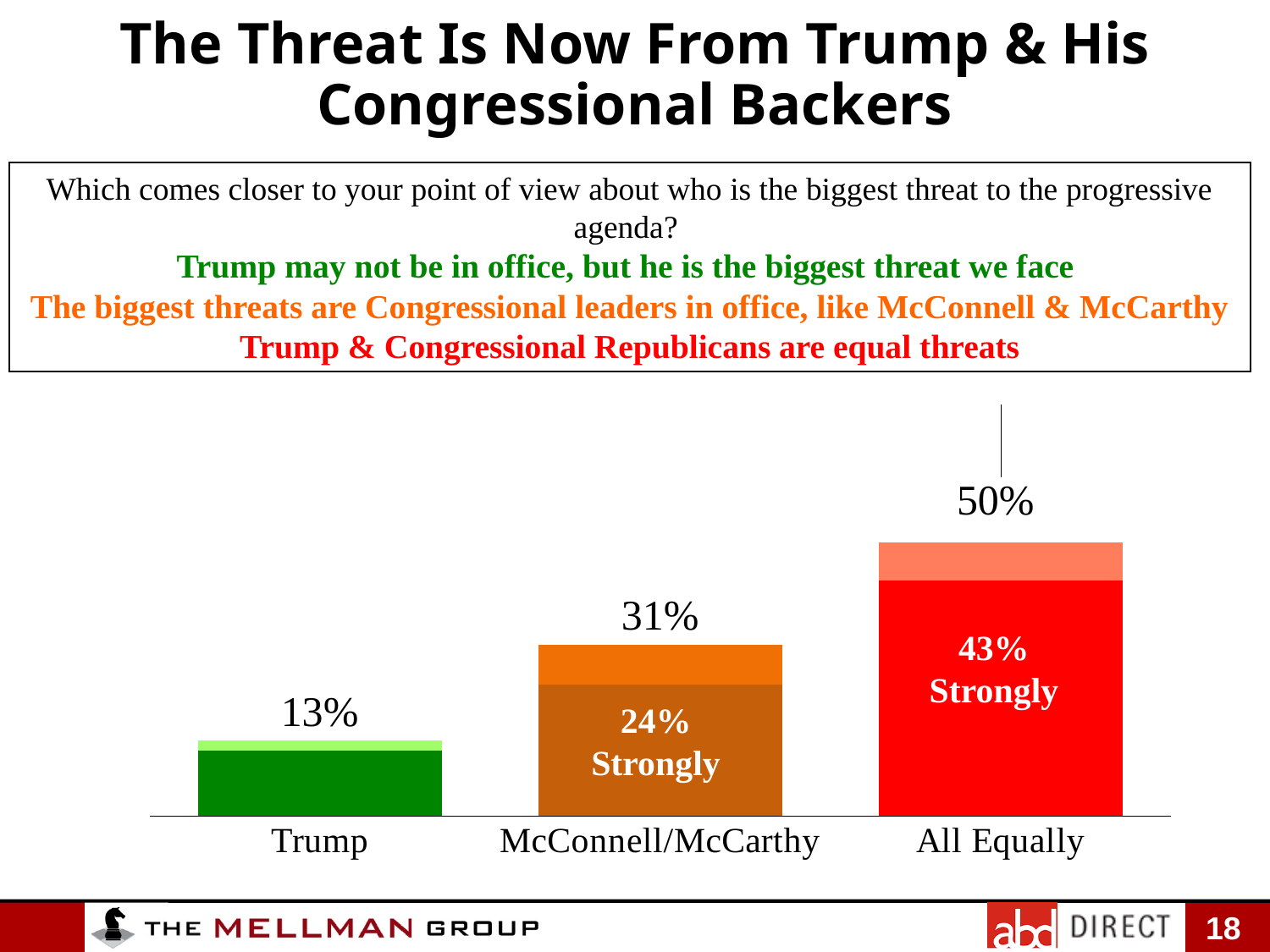
What is the difference between the total for All Equally and the total for McConnell/McCarthy? 19% What kind of chart is shown on the slide? Bar chart Which category has the lowest total value? Trump What is the difference between the total for McConnell/McCarthy and the total for Trump? 18% Which is larger, the 'Strongly' value for All Equally or the 'Strongly' value for McConnell/McCarthy? All Equally What is the 'Strongly' value printed inside the McConnell/McCarthy bar? 24% Which category has the highest total value? All Equally What is the total value shown for the McConnell/McCarthy bar? 31% How many categories are shown on the x axis of the chart? 3 What is the 'Strongly' value printed inside the All Equally bar? 43% What is the total value shown for the Trump bar? 13% What is the total value shown for the All Equally bar? 50%